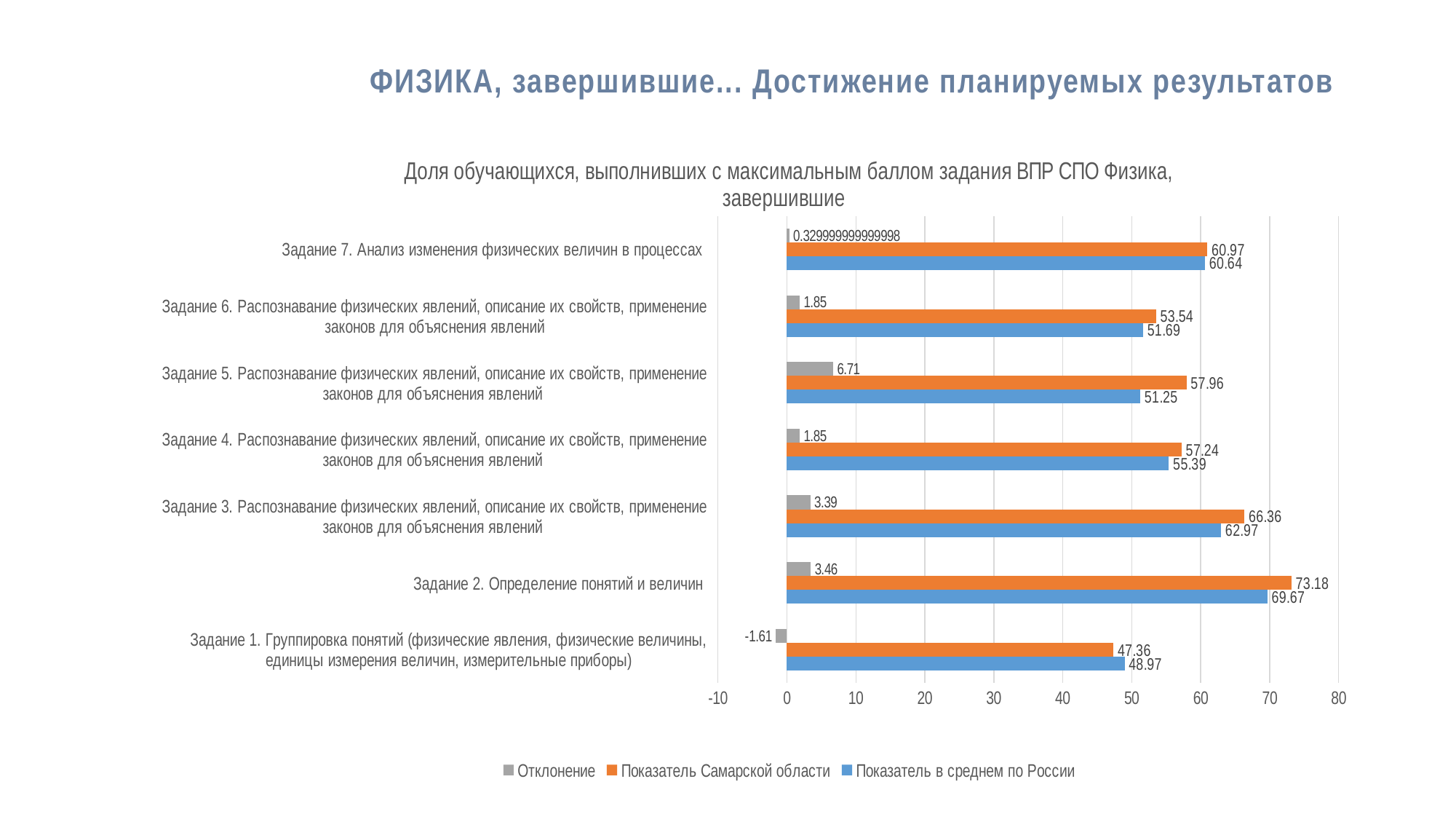
What is the value of Показатель Самарской области for Задание 2. Определение понятий и величин? 73.18 What is the difference between Показатель Самарской области and Показатель в среднем по России for Задание 3? 3.39 What is the Отклонение value for Задание 5? 6.71 What is the value of Показатель в среднем по России for Задание 1? 48.97 Which task has the lowest value for Показатель в среднем по России? Задание 1 For Задание 1, which is larger: Показатель Самарской области or Показатель в среднем по России? Показатель в среднем по России Which task has the highest value for Показатель Самарской области? Задание 2. Определение понятий и величин How many tasks (categories) are plotted on the chart? 7 Which task has the lowest Отклонение value? Задание 1 Which series is shown in orange in the legend? Показатель Самарской области How many series does the legend list? 3 What type of chart is shown on the slide? Bar chart